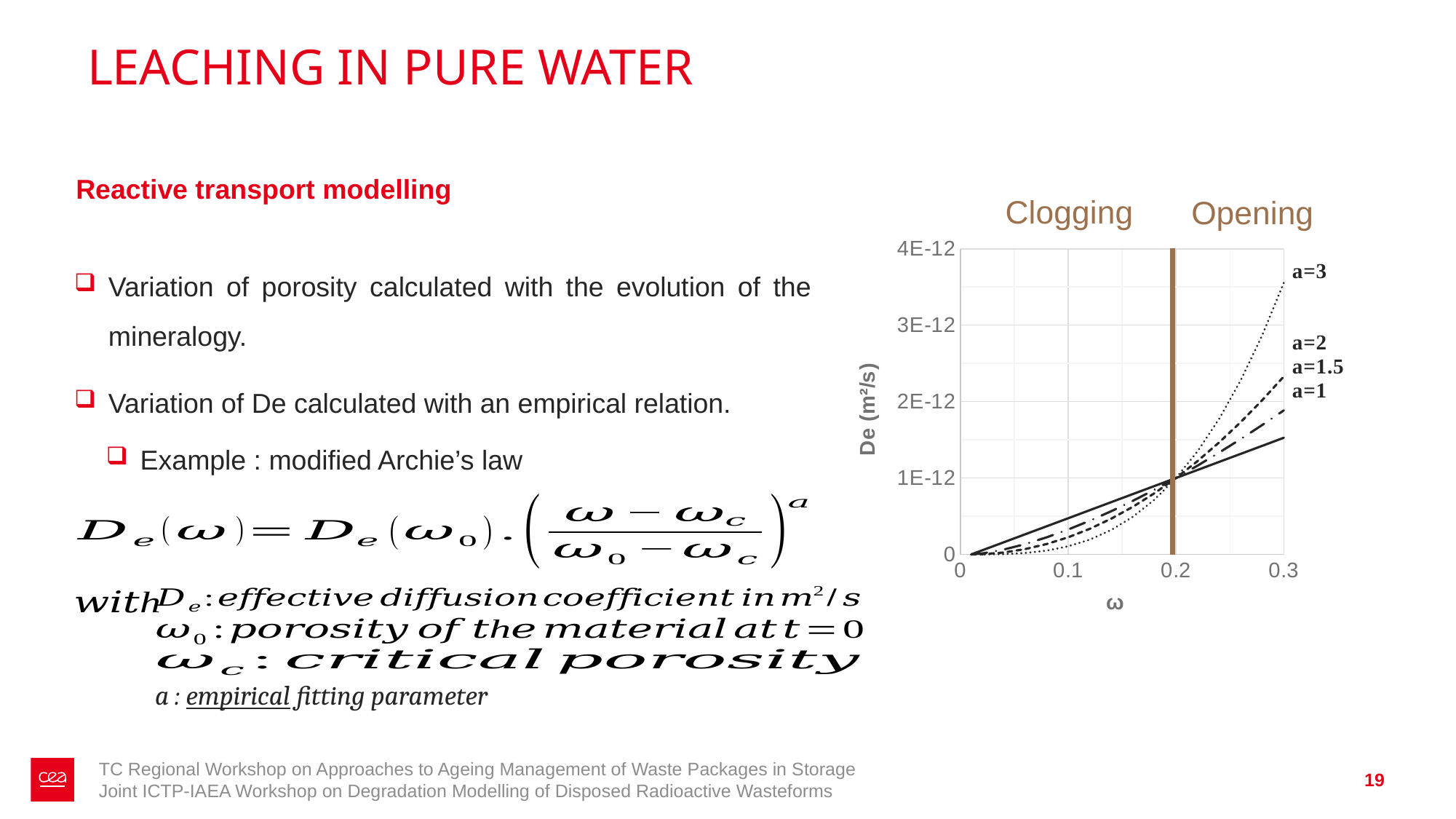
How many curves are labelled on the chart? 4 At ω = 0.1, which curve has the larger De value, a=1 or a=3? a=1 Is the De value of the a=3 curve at ω = 0.3 greater or less than 3E-12? greater What kind of chart is shown on the slide? line chart What is the label of the x axis of the chart? ω At ω = 0.3, which curve has the larger De value, a=2 or a=1.5? a=2 Is the De value of the a=2 curve at ω = 0.3 greater or less than 2E-12? greater Which curve reaches the highest De value at ω = 0.3? a=3 Which curve has the lowest De value at ω = 0.3? a=1 Do the De values rise or fall as ω increases along the x axis? rise What is the label of the y axis of the chart? De (m²/s) Is the De value of the a=1 curve at ω = 0.3 greater or less than 2E-12? less